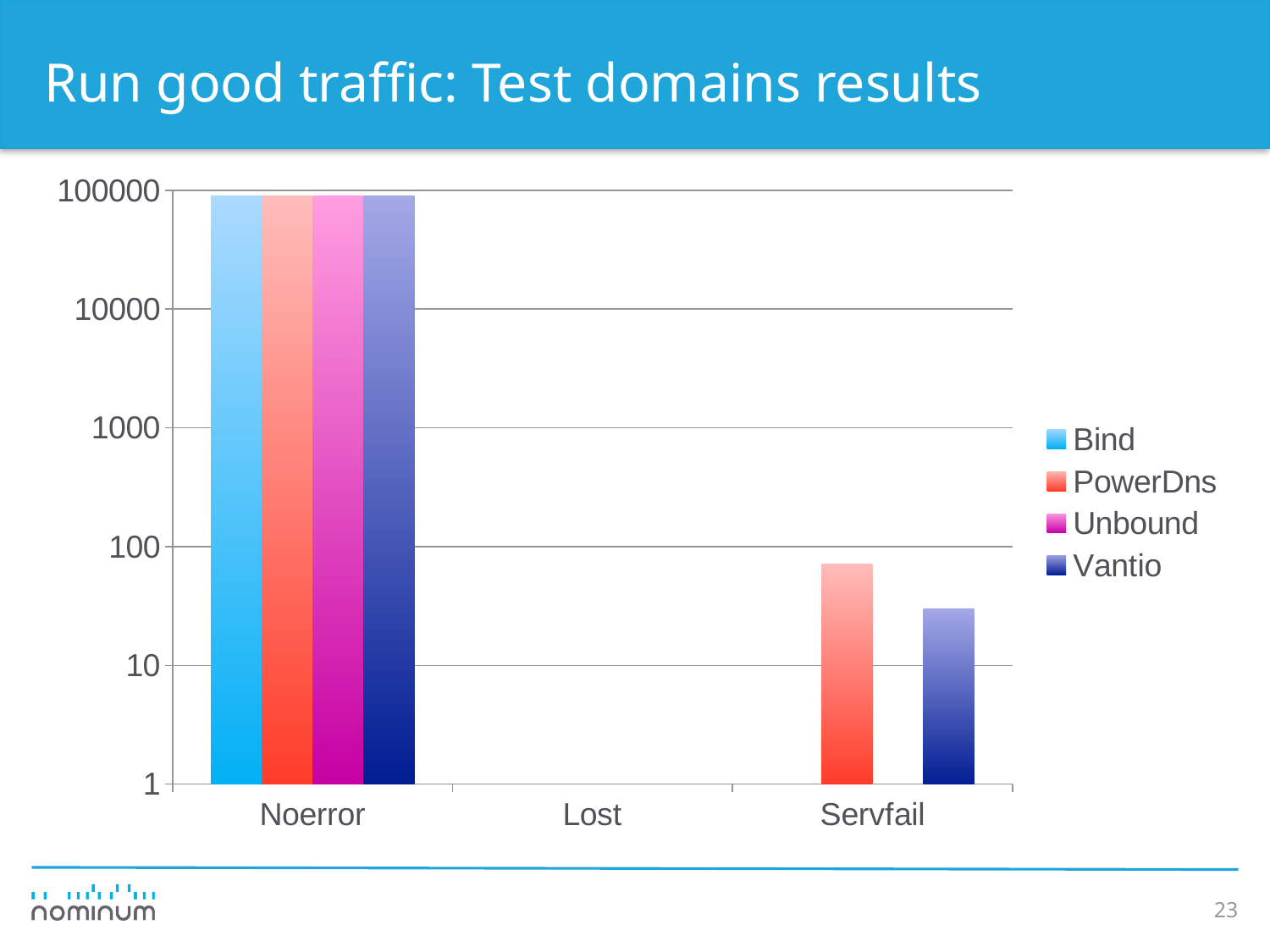
What kind of chart is shown on the slide? bar chart What is the title of the slide containing the chart? Run good traffic: Test domains results Is the value for Vantio in the Servfail category greater or less than 100? less How many categories are shown on the x axis? 3 Which series are listed in the legend? Bind, PowerDns, Unbound, Vantio Which category has no visible bars for any series? Lost Is the value for Vantio in the Servfail category greater or less than 10? greater In the Servfail category, which is larger: PowerDns or Vantio? PowerDns Is the value for Bind in the Noerror category greater or less than 10000? greater How many series does the legend list? 4 Which series has the highest value in the Servfail category? PowerDns